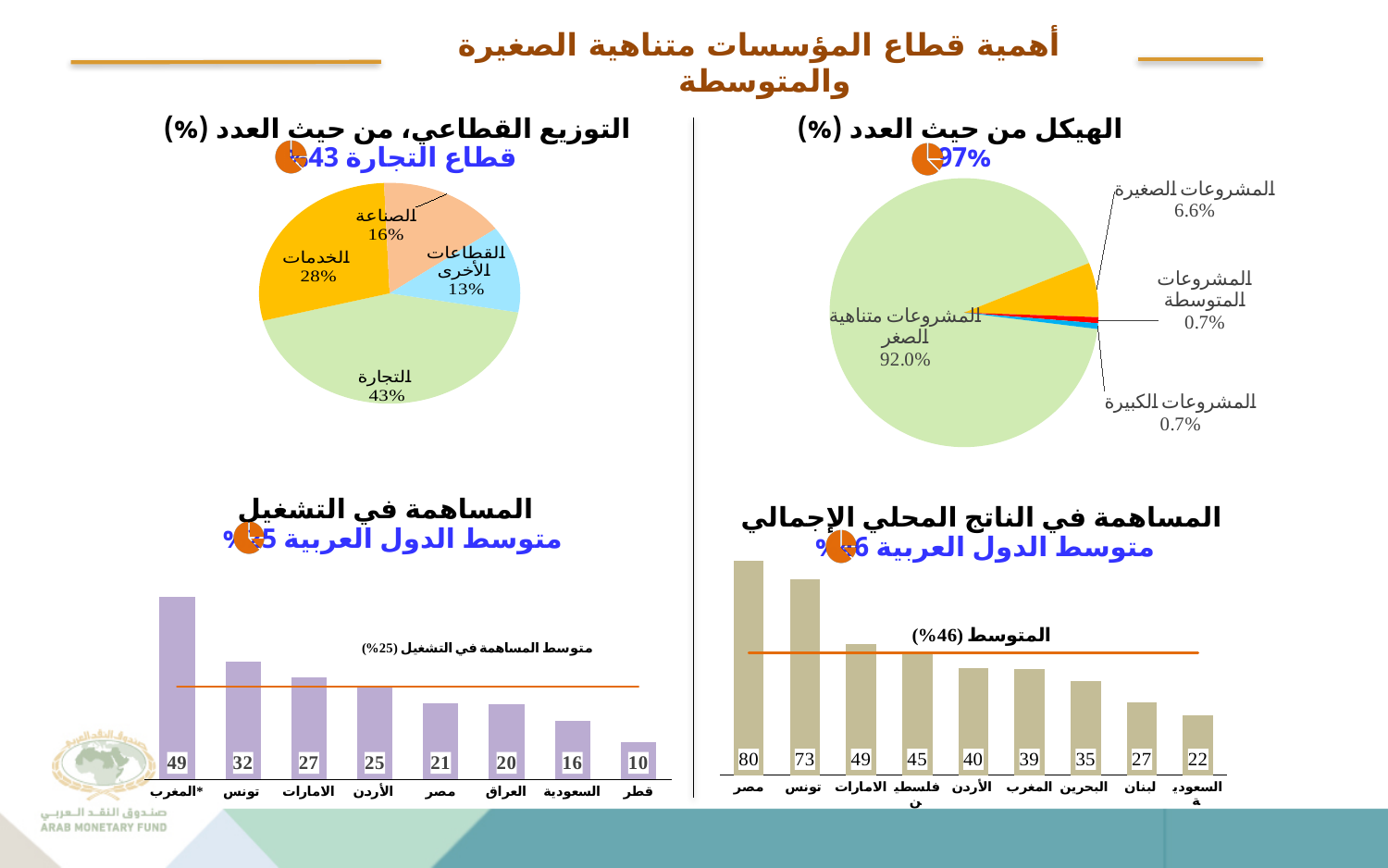
In the chart titled "المساهمة في الناتج المحلي الإجمالي", what is the value for تونس? 73 What type of chart is the one titled "المساهمة في التشغيل"? Bar chart In the chart titled "المساهمة في الناتج المحلي الإجمالي", how many countries are shown? 9 In the pie chart titled "التوزيع القطاعي، من حيث العدد (%)", what is the value for الخدمات? 28% In the pie chart titled "التوزيع القطاعي، من حيث العدد (%)", what is the difference between الصناعة and القطاعات الأخرى? 3% In the pie chart titled "التوزيع القطاعي، من حيث العدد (%)", which sector has the largest share? التجارة In the chart titled "المساهمة في التشغيل", which is larger, the value for تونس or the value for الامارات? تونس In the chart titled "المساهمة في الناتج المحلي الإجمالي", which country has the lowest value? السعودية In the chart titled "المساهمة في التشغيل", what is the value for الأردن? 25 In the pie chart titled "الهيكل من حيث العدد (%)", what is the value for المشروعات الصغيرة? 6.6% In the pie chart titled "الهيكل من حيث العدد (%)", how many slices are there? 4 In the pie chart titled "الهيكل من حيث العدد (%)", what is the value for المشروعات متناهية الصغر? 92.0%